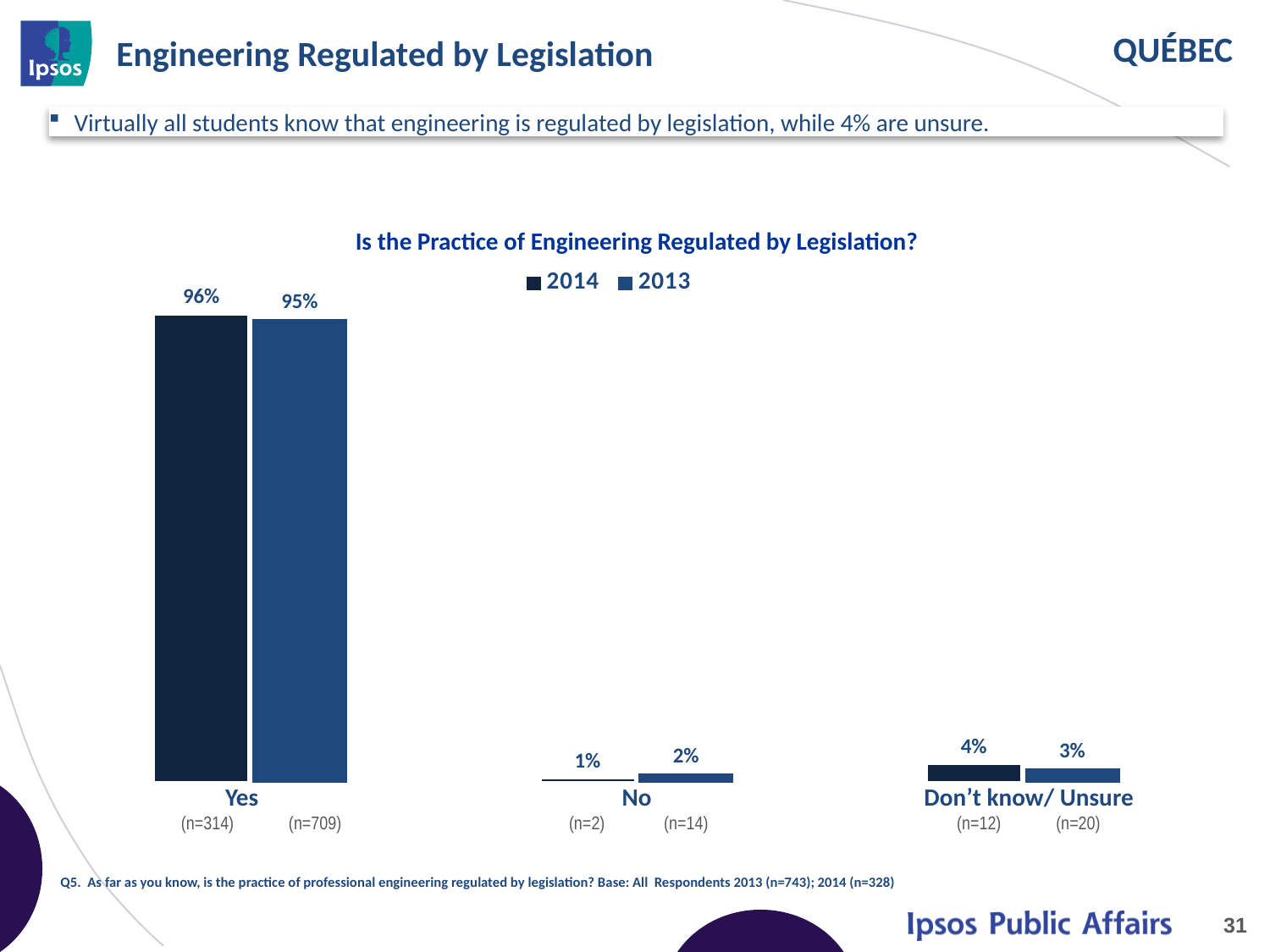
What kind of chart is shown? bar chart How many series does the legend list? 2 What is the 2013 value for Don't know/ Unsure? 3% What is the 2014 value for Yes? 96% Which is larger for Don't know/ Unsure: the 2014 value or the 2013 value? 2014 Which category has the highest 2014 value? Yes What is the title of the chart? Is the Practice of Engineering Regulated by Legislation? What is the 2013 value for No? 2% How many categories are shown on the x axis? 3 What is the 2014 value for No? 1% What is the difference between the 2014 and 2013 values for Yes? 1% Which category has the lowest 2013 value? No